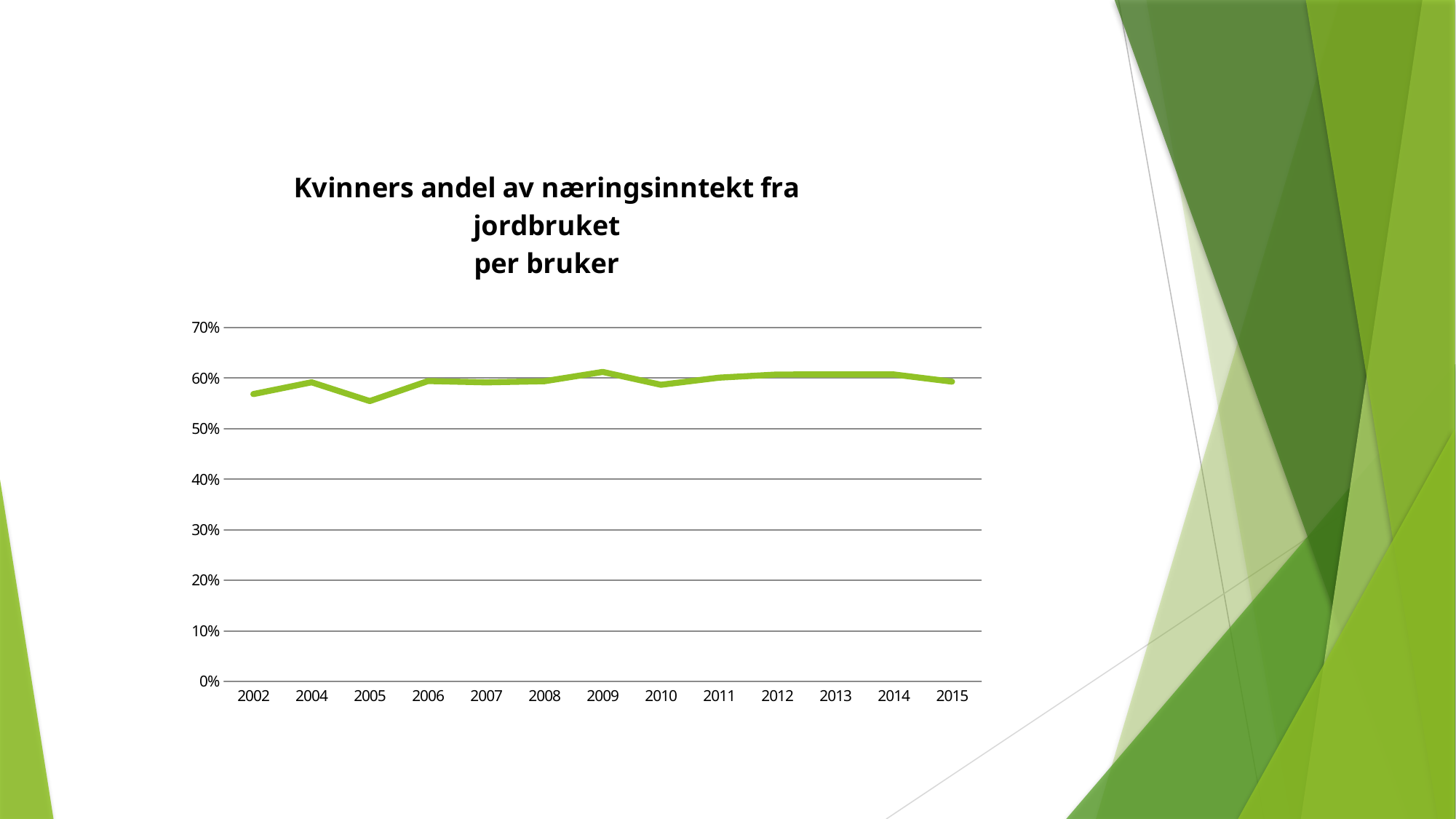
Is the value for 2002 greater or less than 60%? less What is the highest value shown on the y axis of the chart? 70% Which year has the larger value, 2005 or 2009? 2009 What kind of chart is shown on the slide? line chart Which year has the lowest value in the chart? 2005 Does the value rise or fall from 2004 to 2005? fall Is the value for 2009 greater or less than 60%? greater Which year has the larger value, 2002 or 2004? 2004 Is the value for 2005 greater or less than 60%? less What is the title of the chart? Kvinners andel av næringsinntekt fra jordbruket per bruker How many years are plotted on the x axis of the chart? 13